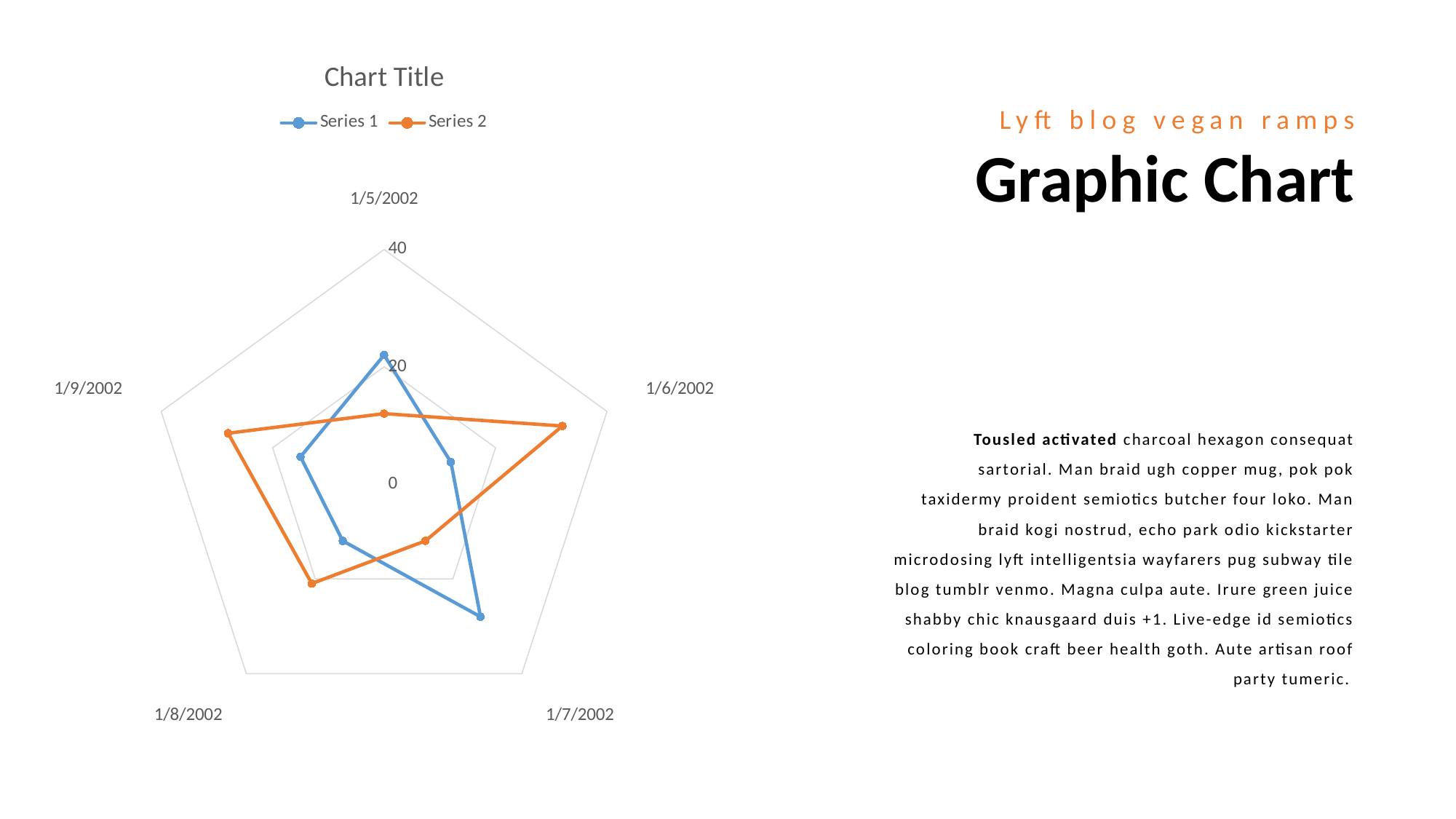
At 1/6/2002, which series has the larger value, Series 1 or Series 2? Series 2 Is the Series 2 value for 1/5/2002 greater or less than 20? less What is the title of the chart? Chart Title Is the Series 1 value for 1/7/2002 greater or less than 20? greater Is the Series 2 value for 1/9/2002 greater or less than 20? greater For which date does Series 1 have its highest value? 1/7/2002 At 1/5/2002, which series has the larger value, Series 1 or Series 2? Series 1 How many series does the chart legend list? 2 How many categories (dates) are plotted on the radar chart? 5 What kind of chart is shown on the slide? Radar chart